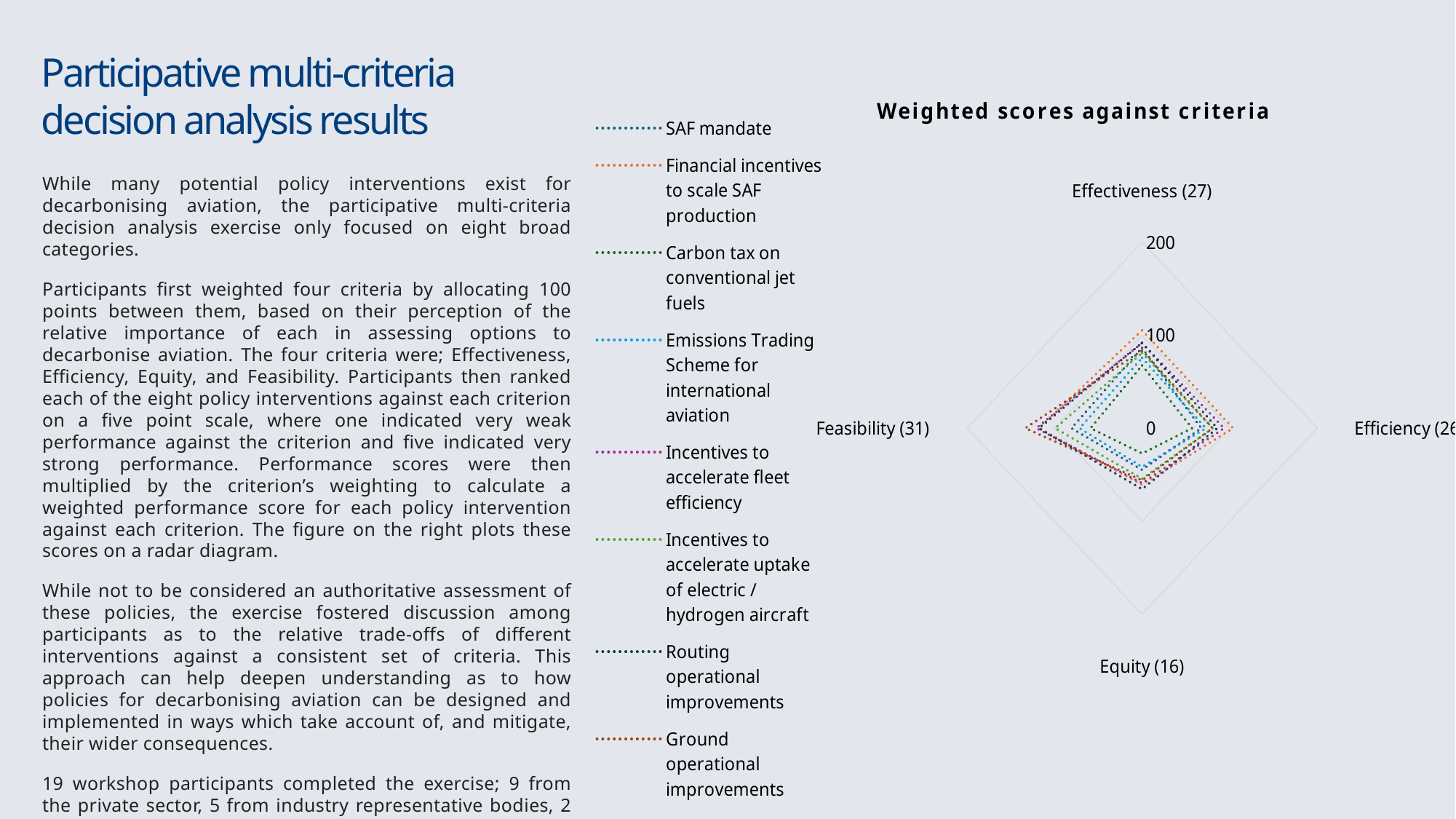
On the radar chart, is the highest Feasibility score for any policy intervention greater or less than 200? less On the radar chart, is the highest Equity score for any policy intervention greater or less than 100? less On the radar chart, is the highest Effectiveness score for any policy intervention greater or less than 200? less How many policy interventions (series) does the legend of the radar chart list? 8 What is the title of the radar chart? Weighted scores against criteria How many criteria (axes) does the radar chart plot? 4 What is the highest tick value shown on the radar chart's scale? 200 What kind of chart is shown under the title "Weighted scores against criteria"? Radar chart